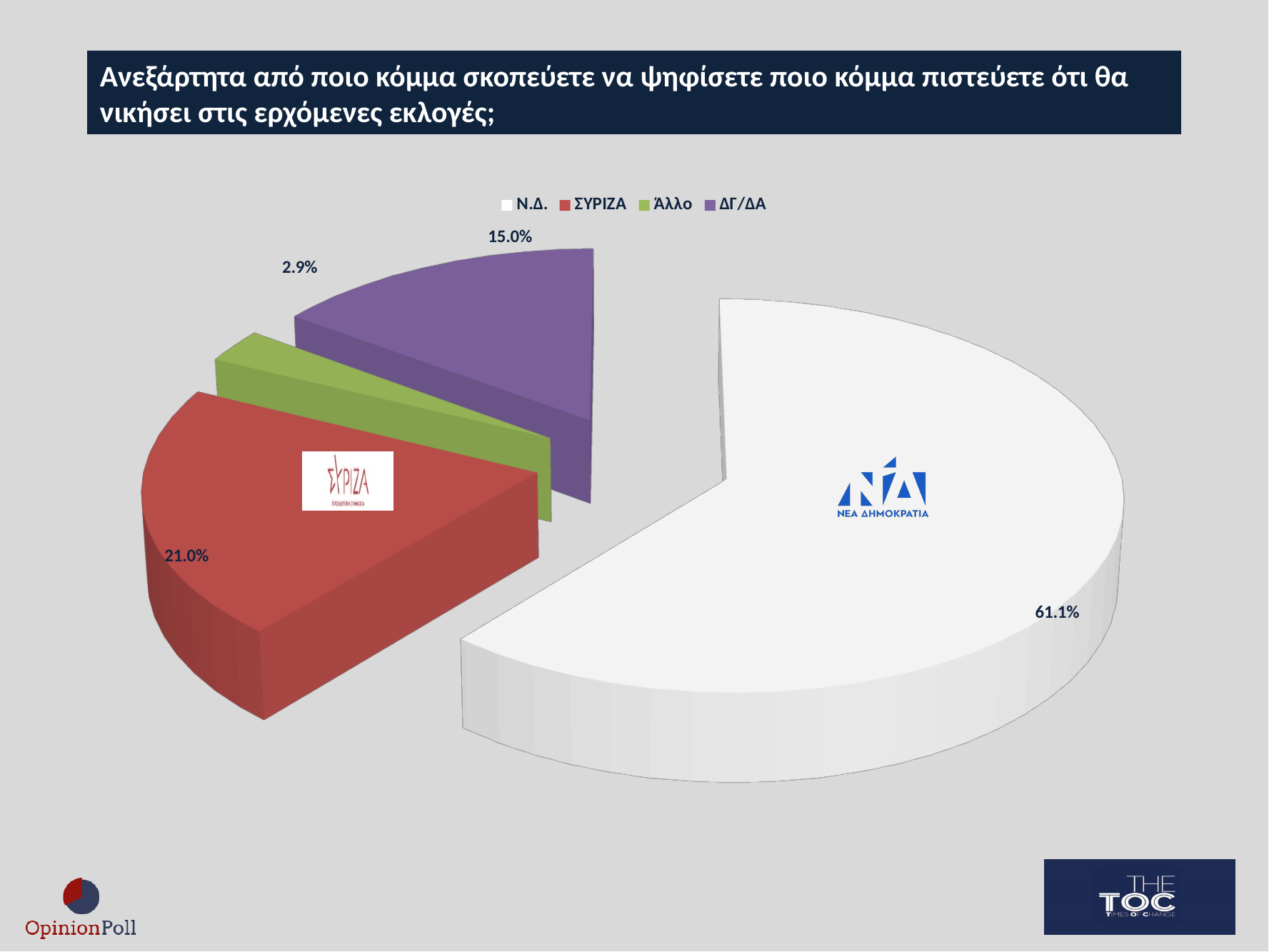
What percentage of the pie is the ΣΥΡΙΖΑ slice? 21.0% Which category has the smallest slice of the pie? Άλλο What percentage of the pie is the ΔΓ/ΔΑ slice? 15.0% What is the difference in percentage points between the ΣΥΡΙΖΑ slice and the ΔΓ/ΔΑ slice? 6.0 What is the difference in percentage points between the Ν.Δ. slice and the ΣΥΡΙΖΑ slice? 40.1 How many slices does the pie chart have? 4 Which slice is larger, ΔΓ/ΔΑ or Άλλο? ΔΓ/ΔΑ What percentage of the pie is the Άλλο slice? 2.9% What kind of chart is shown on the slide? Pie chart What percentage of the pie is the Ν.Δ. slice? 61.1% Which category has the largest slice of the pie? Ν.Δ. What colour is the ΔΓ/ΔΑ slice in the pie chart? Purple